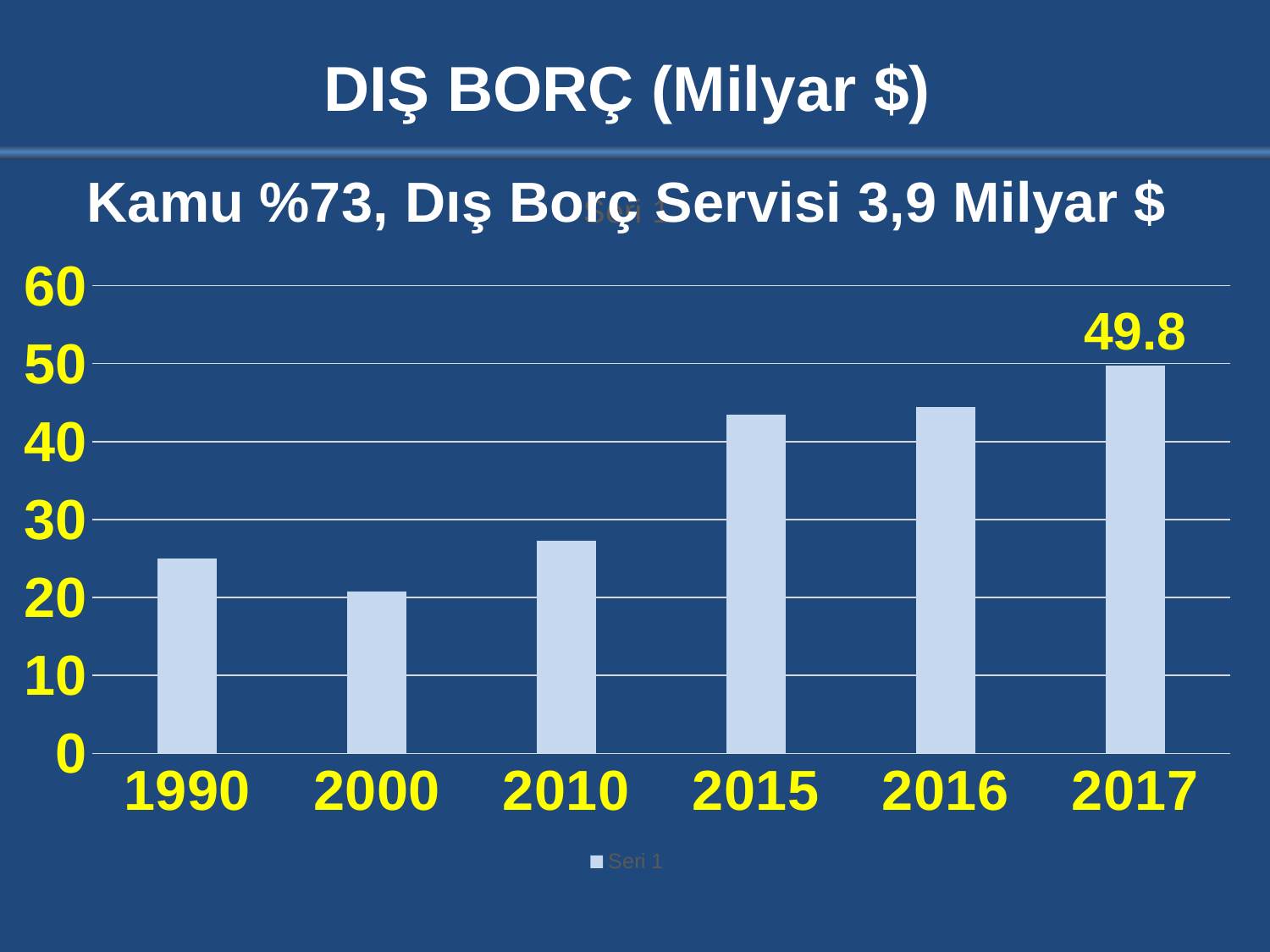
How many years are shown on the x axis? 6 Which is larger, the value for 2010 or the value for 2015? 2015 Which year has the lowest bar? 2000 Is the value for 2016 greater or less than 50? less Is the value for 2015 greater or less than 40? greater Is the value for 1990 greater or less than 30? less What is the value shown for 2017? 49.8 Do the values rise or fall from 2000 to 2017? rise Which year has the highest bar? 2017 What is the title at the top of the slide? DIŞ BORÇ (Milyar $) What kind of chart is shown on the slide? bar chart